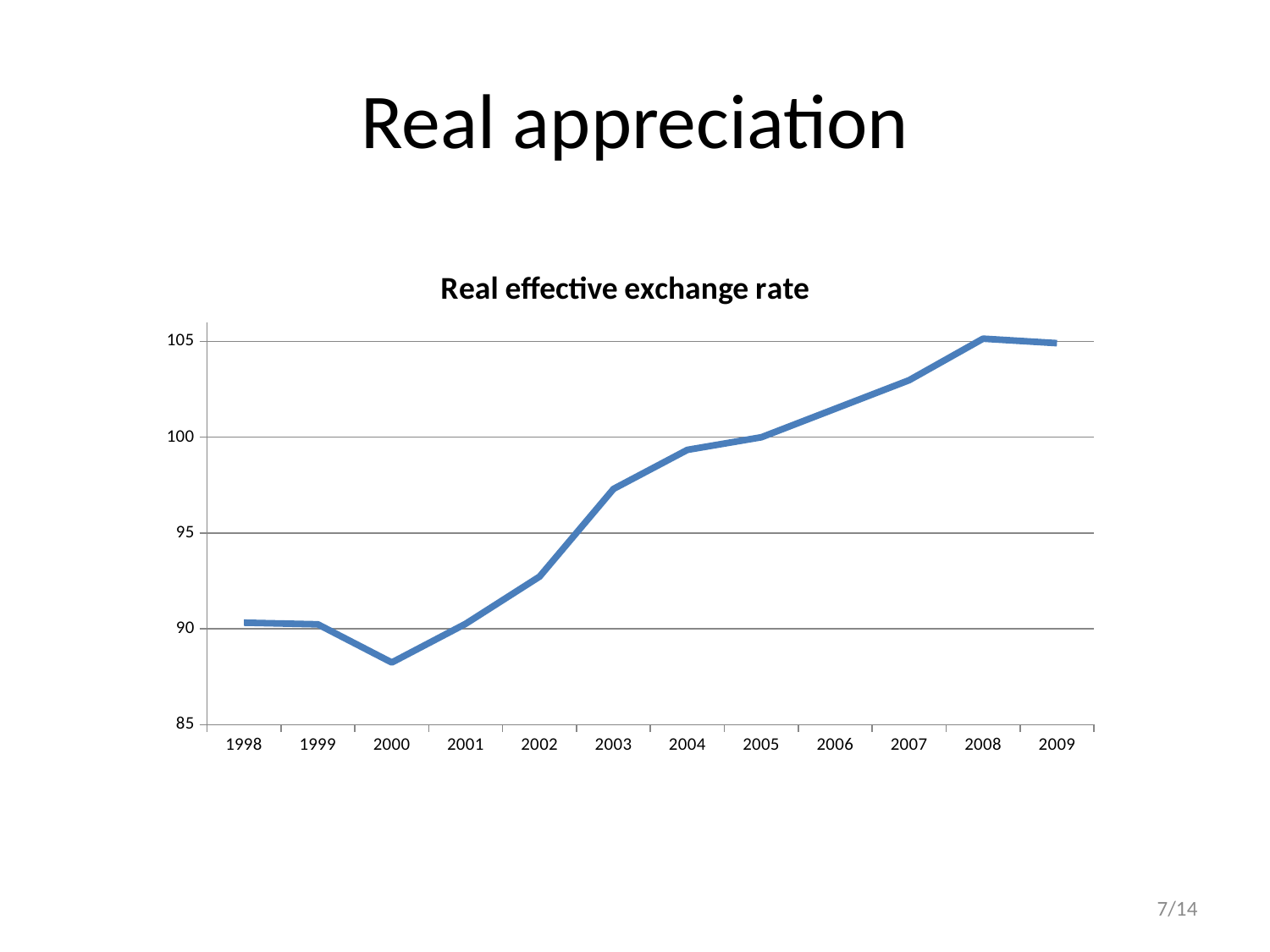
How many years are plotted on the x axis of the chart? 12 Is the value for 2002 greater or less than 95? less Is the value for 2000 greater or less than 90? less What kind of chart is shown on the slide? line chart Is the value for 2007 greater or less than 100? greater Which year has the lowest real effective exchange rate? 2000 Which year has the higher value, 2002 or 2003? 2003 Does the real effective exchange rate generally rise or fall from 2000 to 2008? rise What is the title of the chart? Real effective exchange rate Which year has the higher value, 2001 or 2007? 2007